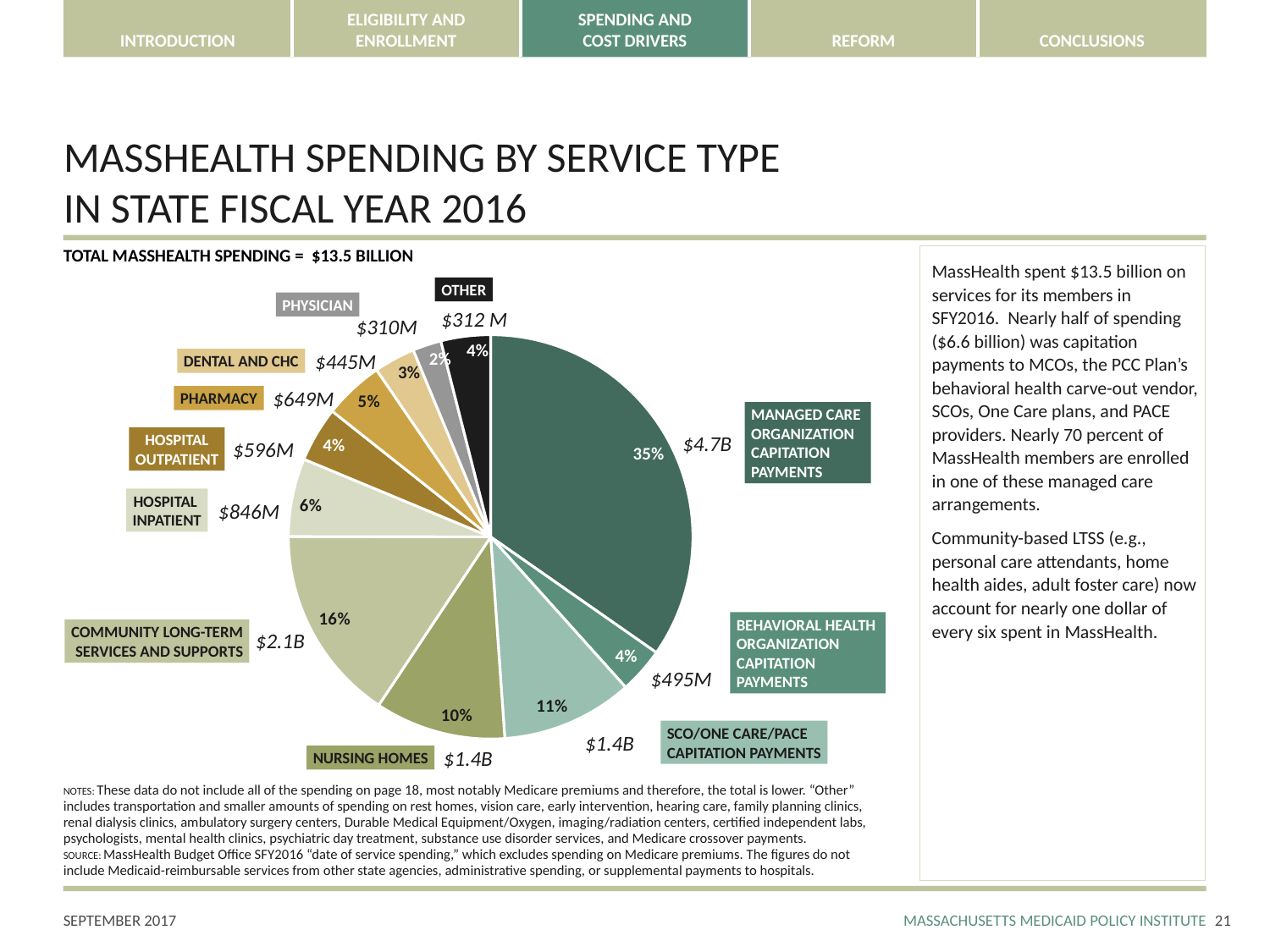
Which service type accounted for the smallest share of MassHealth spending? Physician What is the difference in spending between Hospital Inpatient and Hospital Outpatient? $250M What share of MassHealth spending went to Managed Care Organization Capitation Payments? 35% Which service type accounted for the largest share of MassHealth spending? Managed Care Organization Capitation Payments How many service type categories are shown in the pie chart? 11 What type of chart is shown on the slide? Pie chart What was the dollar amount of spending on Hospital Inpatient services? $846M What share of spending went to Pharmacy? 5% What was the total MassHealth spending shown above the chart? $13.5 billion Which had a larger share of spending, Nursing Homes or SCO/One Care/PACE Capitation Payments? SCO/One Care/PACE Capitation Payments What was the dollar amount of spending on Community Long-Term Services and Supports? $2.1B What was the dollar amount of spending on Behavioral Health Organization Capitation Payments? $495M